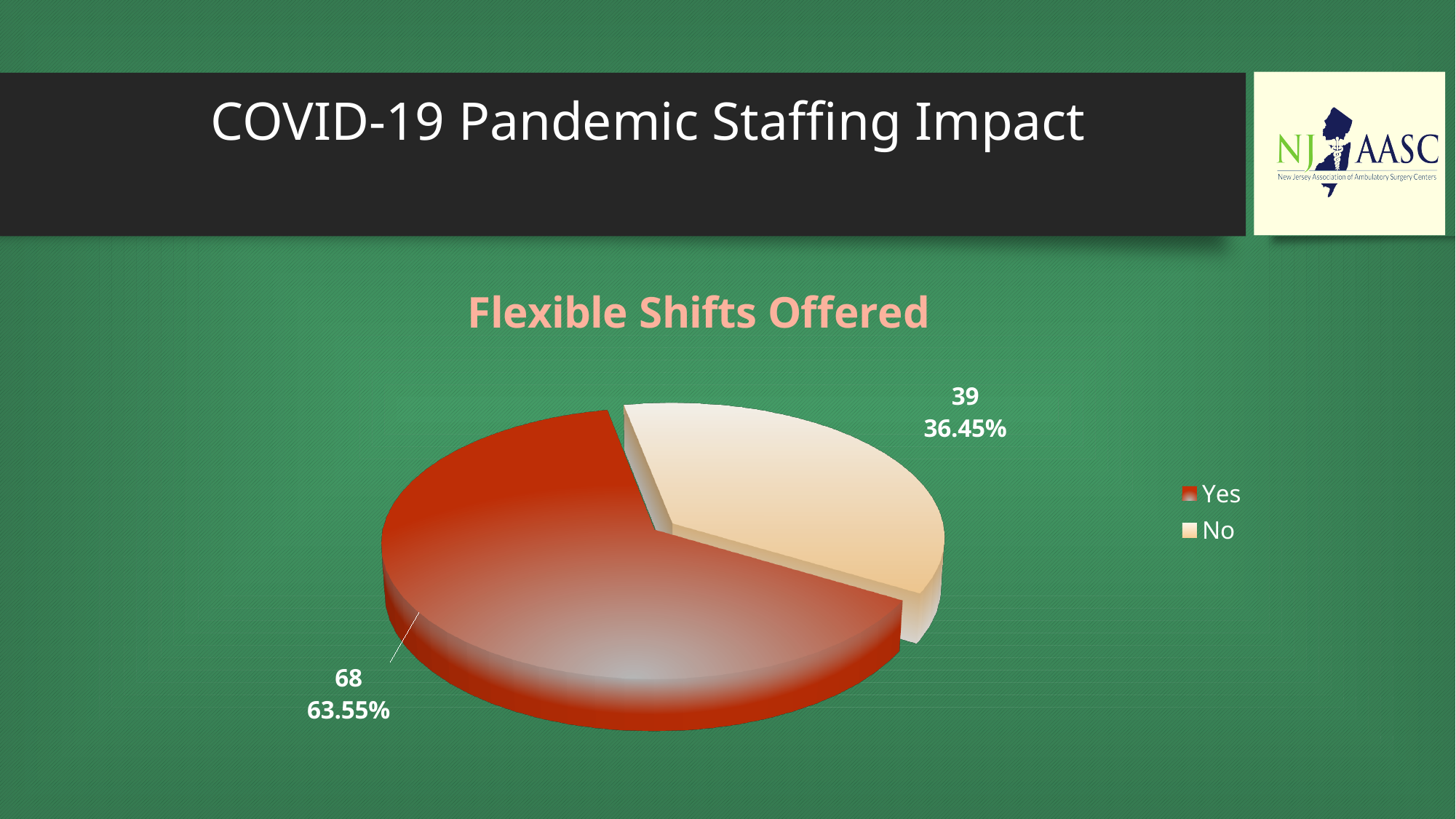
What is the difference between the Yes count and the No count? 29 Which slice is the smallest? No What kind of chart is shown on the slide? pie chart How many entries does the legend list? 2 What is the title of the chart? Flexible Shifts Offered What share of the pie does the No slice represent? 36.45% What share of the pie does the Yes slice represent? 63.55% Which slice is the largest? Yes How many slices does the pie chart have? 2 What is the count for the Yes slice? 68 What is the total of the Yes and No counts? 107 What is the count for the No slice? 39